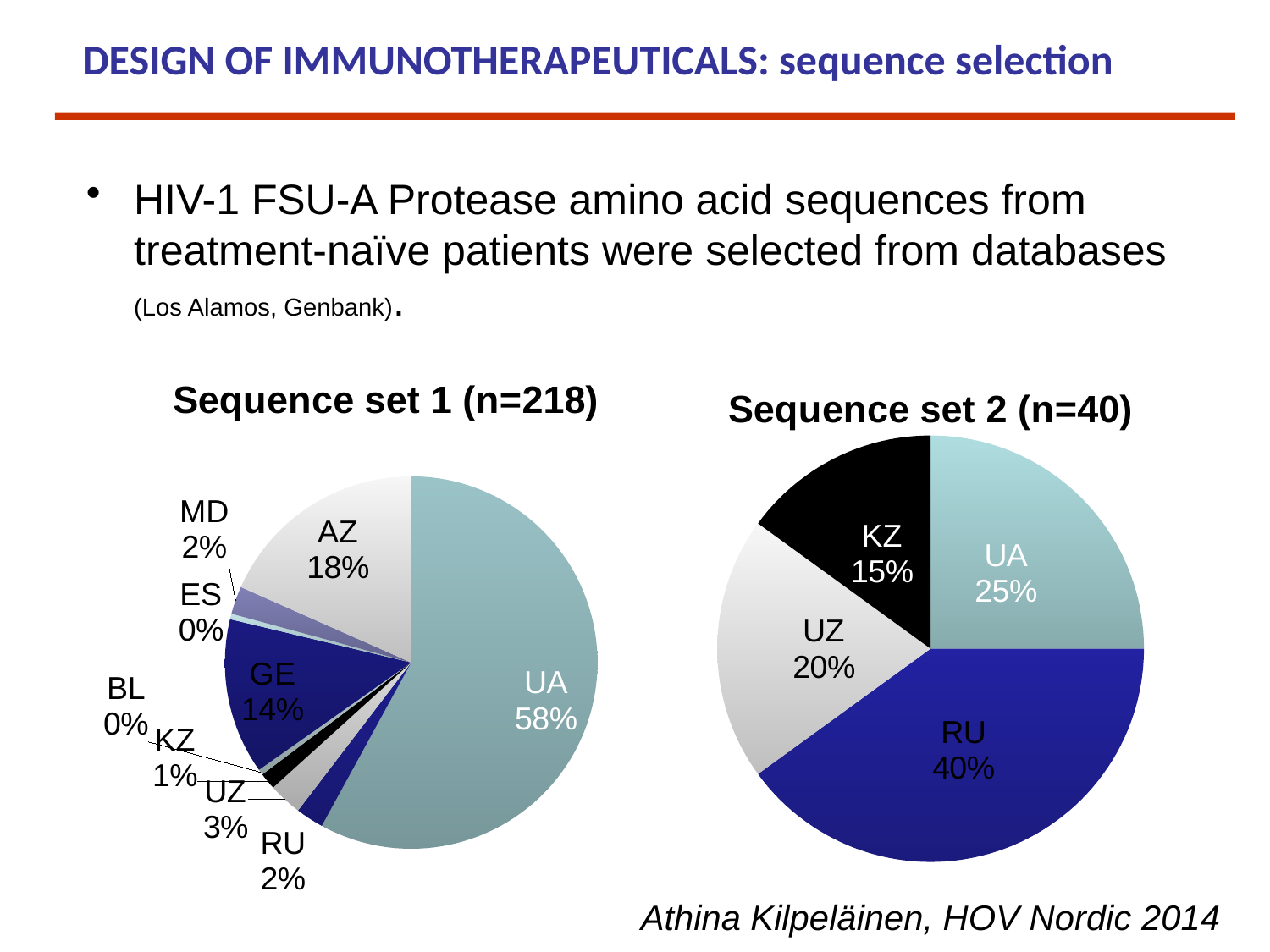
In the Sequence set 1 (n=218) chart, which category has the largest share? UA In the Sequence set 2 (n=40) chart, which is larger, the share of UA or the share of UZ? UA In the Sequence set 1 (n=218) chart, what is the difference between the shares of AZ and GE? 4% In the Sequence set 2 (n=40) chart, what share does RU have? 40% What kind of chart is the Sequence set 1 (n=218) chart? Pie chart In the Sequence set 1 (n=218) chart, what share does UA have? 58% In the Sequence set 2 (n=40) chart, which category has the largest share? RU In the Sequence set 1 (n=218) chart, what share does GE have? 14% In the Sequence set 2 (n=40) chart, which category has the smallest share? KZ How many categories are shown in the Sequence set 2 (n=40) chart? 4 In the Sequence set 2 (n=40) chart, what share does KZ have? 15% In the Sequence set 1 (n=218) chart, what is the combined share of UZ and RU? 5%